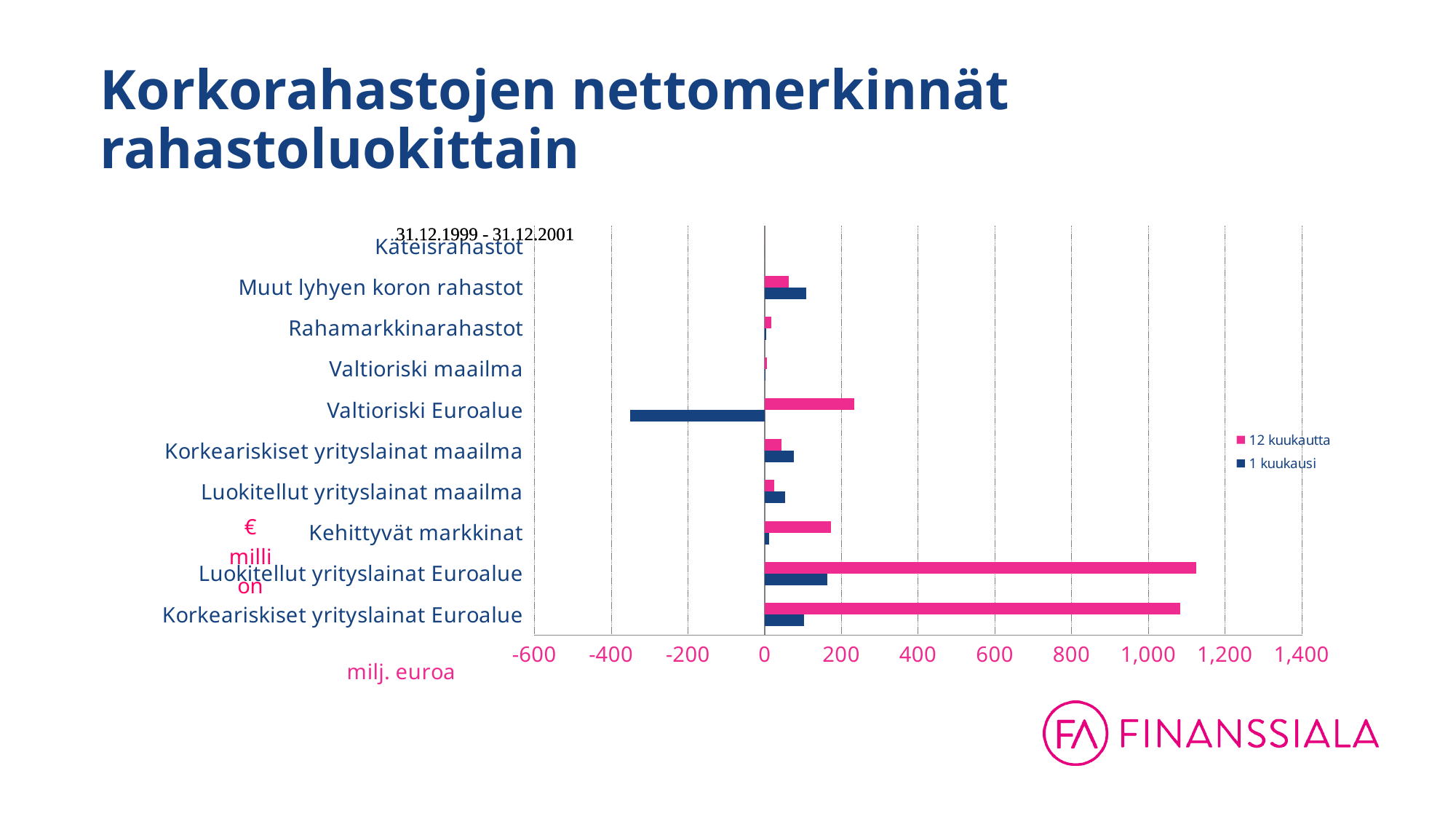
For the 12 kuukautta series, which is larger: Valtioriski Euroalue or Kehittyvät markkinat? Valtioriski Euroalue Is the 12 kuukautta value for Luokitellut yrityslainat Euroalue greater or less than 1,000? greater What unit is shown on the x axis of the chart? milj. euroa Is the 12 kuukautta value for Korkeariskiset yrityslainat Euroalue greater or less than 1,000? greater Is the 1 kuukausi value for Valtioriski Euroalue greater or less than -200? less How many fund categories are shown on the chart? 10 For the 1 kuukausi series, which is larger: Luokitellut yrityslainat Euroalue or Korkeariskiset yrityslainat Euroalue? Luokitellut yrityslainat Euroalue How many series does the legend list? 2 What kind of chart is shown on the slide? bar chart Which category has the lowest value for the 1 kuukausi series? Valtioriski Euroalue